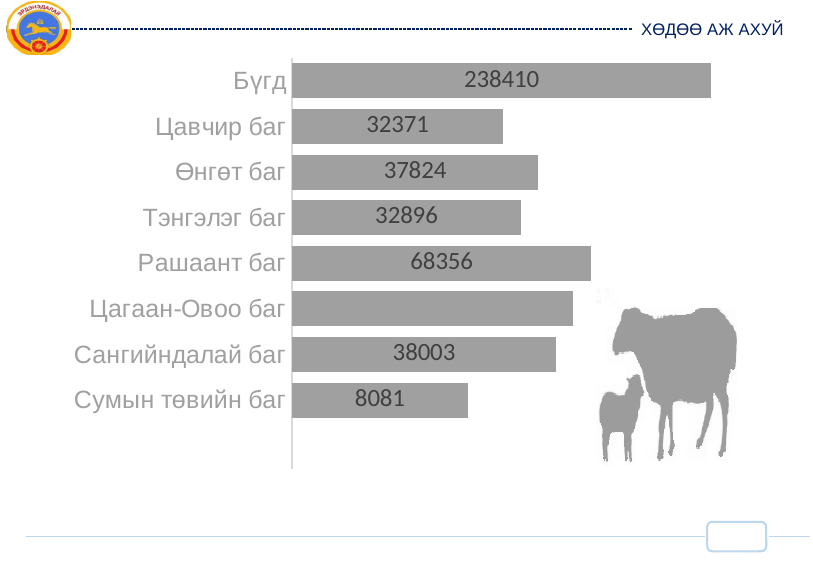
Which category has the lowest value? Сумын төвийн баг What is the value for Рашаант баг? 68356 Which is larger, the value for Өнгөт баг or Тэнгэлэг баг? Өнгөт баг What type of chart is shown on the slide? Bar chart What is the value for Сумын төвийн баг? 8081 Which category has the longest bar? Бүгд Excluding Бүгд, which баг has the highest value? Рашаант баг What is the value for Сангийндалай баг? 38003 What is the value for Бүгд? 238410 What is the value for Цавчир баг? 32371 What is the difference between the values for Рашаант баг and Цавчир баг? 35985 How many categories are shown in the chart? 8